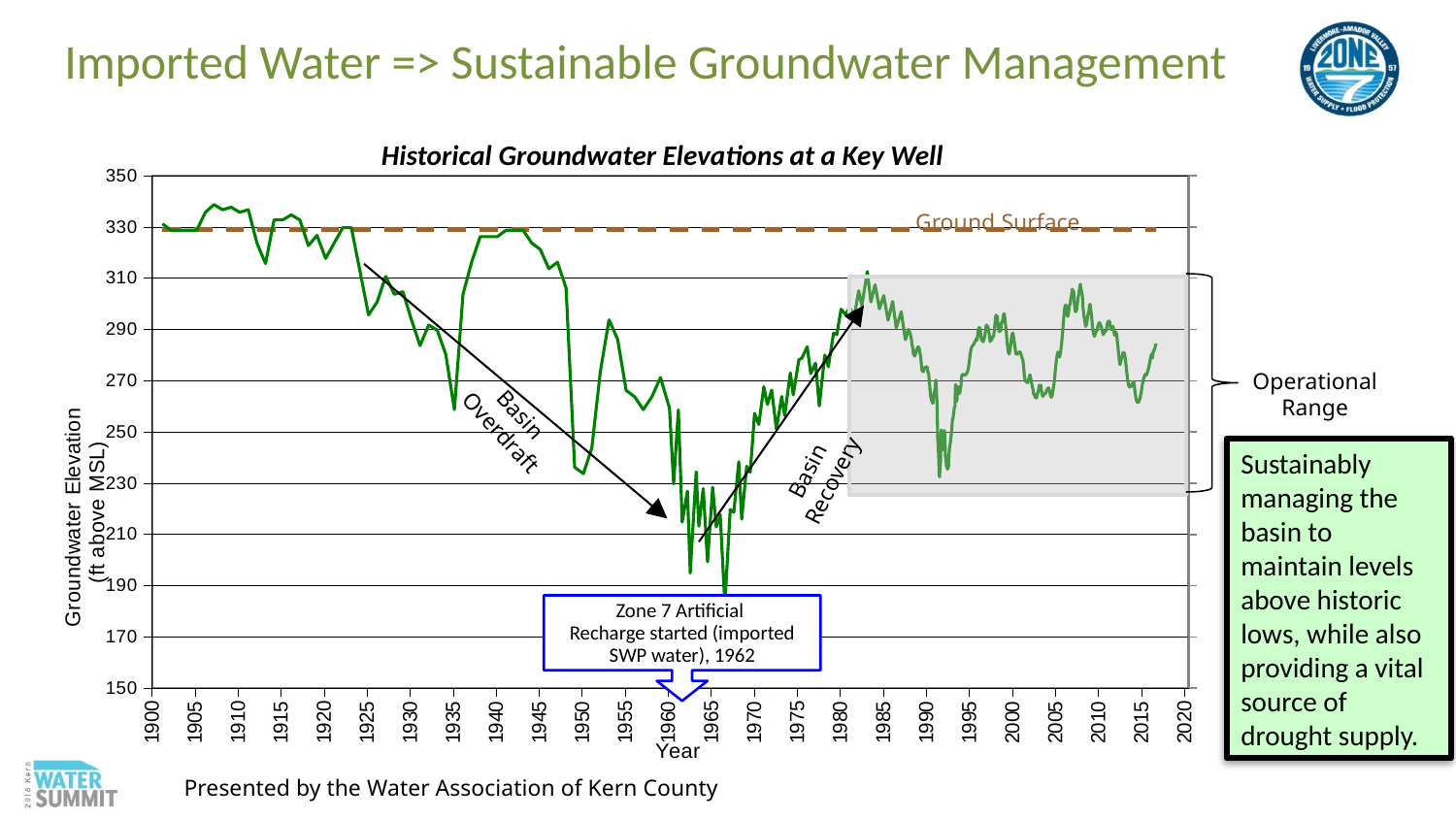
Is the groundwater elevation around 1950 greater or less than 250? less What is the label of the vertical axis of the chart? Groundwater Elevation (ft above MSL) Is the groundwater elevation around 1992 greater or less than 250? less What is the title of the chart? Historical Groundwater Elevations at a Key Well Is the groundwater elevation around 1910 greater or less than 310? greater In what year does the chart annotation say Zone 7 Artificial Recharge started? 1962 Between 1925 and 1965, do the groundwater elevations generally rise or fall? fall Between 1965 and 1985, do the groundwater elevations generally rise or fall? rise Is the groundwater elevation around 1965 higher or lower than around 1985? lower What kind of chart is shown on the slide? Line chart